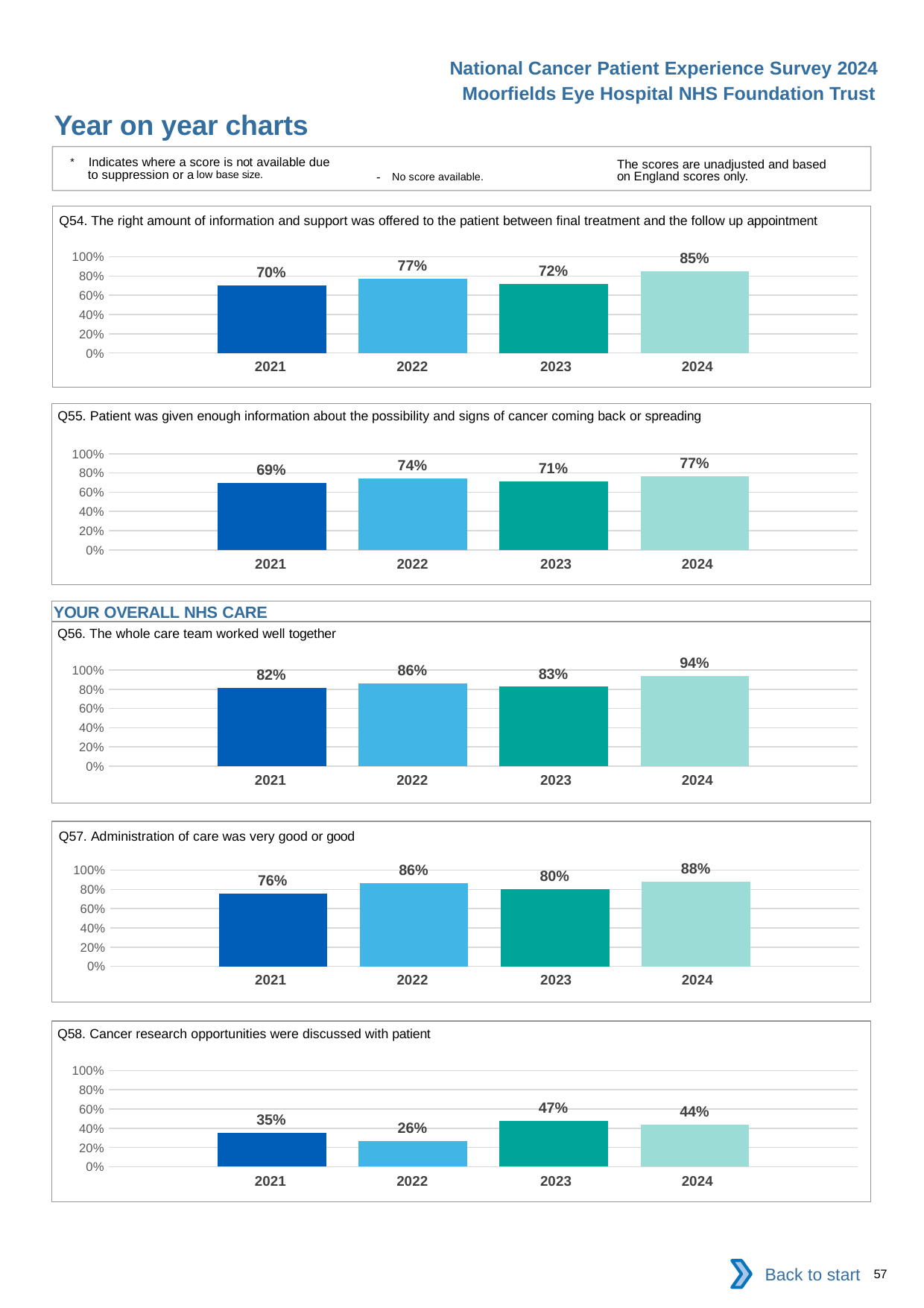
How many bars are shown in the Q54 chart? 4 In the Q58 chart, what is the value for 2022? 26% In the Q56 chart, what is the difference between the 2024 and 2021 values? 12% In the Q54 chart, what is the value for 2024? 85% In the Q58 chart, is the value for 2024 greater or less than 40%? greater In the Q57 chart, what is the difference between the 2024 and 2021 values? 12% In the Q55 chart, which year has the lowest value? 2021 In the Q57 chart, which is larger, the value for 2022 or the value for 2023? 2022 In the Q58 chart, which year has the highest value? 2023 In the Q55 chart, what is the value for 2023? 71% What is the section heading shown above the Q56 chart? YOUR OVERALL NHS CARE What type of chart is used for Q56? Bar chart